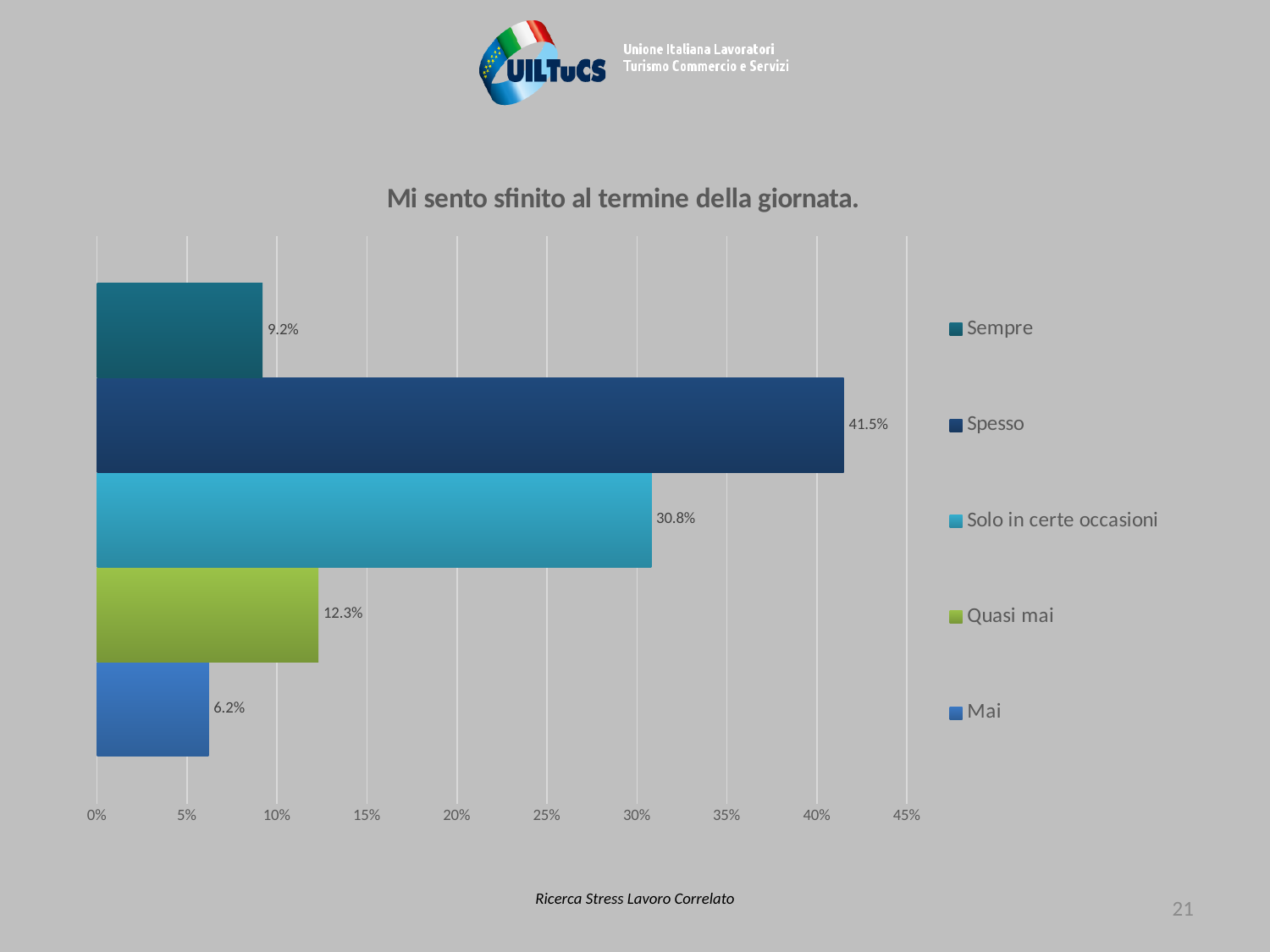
What is the value for Sempre? 9.2% What is the value for Solo in certe occasioni? 30.8% Which category has the lowest value? Mai What is the difference between the values for Spesso and Solo in certe occasioni? 10.7% What is the value for Spesso? 41.5% What is the title of the chart? Mi sento sfinito al termine della giornata. Which is larger, the value for Quasi mai or the value for Sempre? Quasi mai What is the value for Mai? 6.2% What kind of chart is shown on the slide? bar chart Is the value for Solo in certe occasioni greater or less than 25%? greater Which category has the highest value? Spesso How many categories are shown in the chart? 5